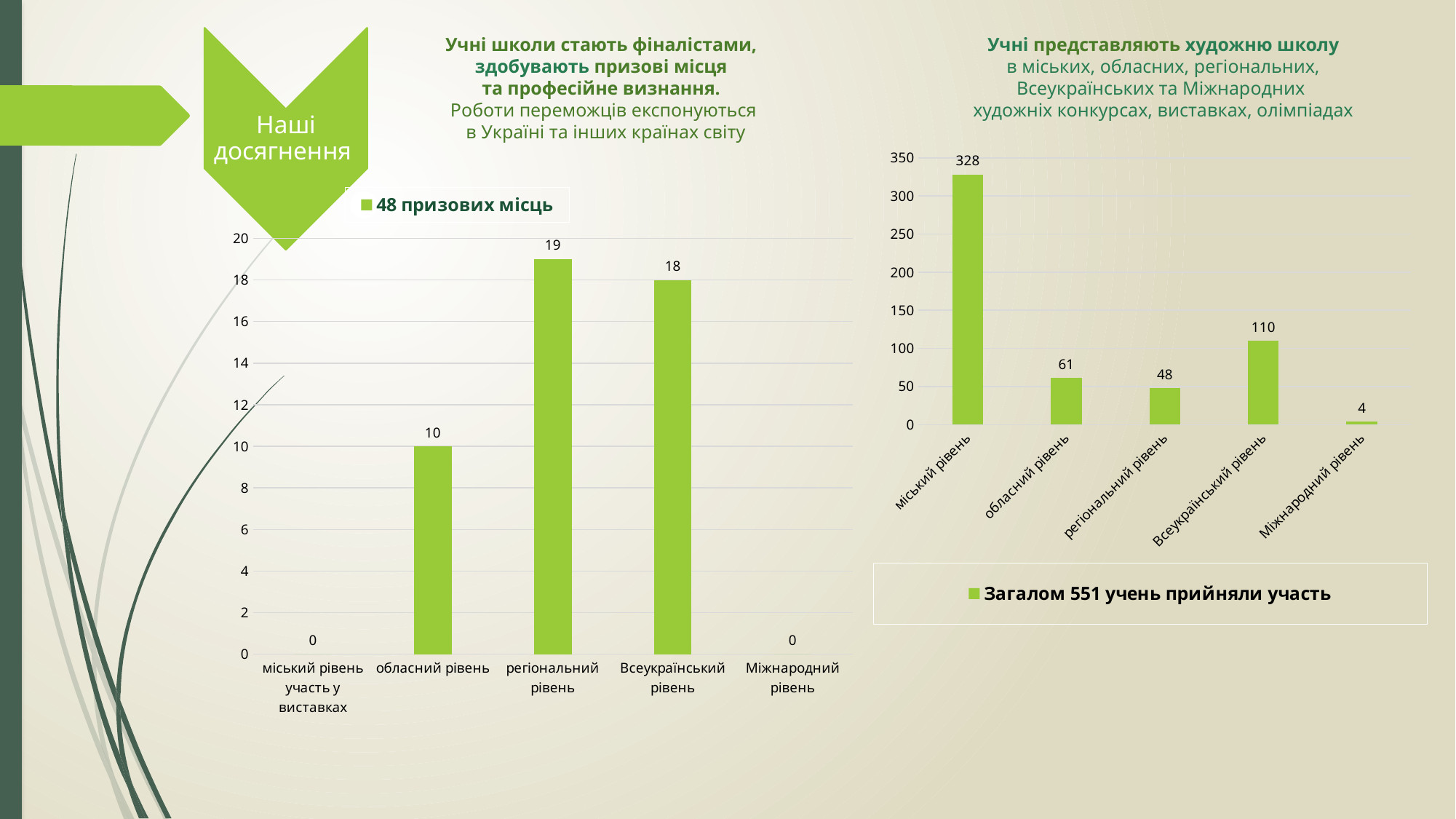
In the right chart (legend "Загалом 551 учень прийняли участь"), what is the value for міський рівень? 328 How many series does the legend of the left chart list? 1 In the right chart (legend "Загалом 551 учень прийняли участь"), what is the difference between міський рівень and Всеукраїнський рівень? 218 In the left chart (legend "48 призових місць"), what is the value for регіональний рівень? 19 In the right chart (legend "Загалом 551 учень прийняли участь"), which is larger: обласний рівень or регіональний рівень? обласний рівень In the left chart (legend "48 призових місць"), what is the difference between Всеукраїнський рівень and обласний рівень? 8 In the left chart (legend "48 призових місць"), how many categories are shown on the x axis? 5 In the right chart (legend "Загалом 551 учень прийняли участь"), which category has the lowest value? Міжнародний рівень What type of chart is the right chart (legend "Загалом 551 учень прийняли участь")? bar chart In the left chart (legend "48 призових місць"), what is the value for обласний рівень? 10 In the left chart (legend "48 призових місць"), which category has the highest value? регіональний рівень In the right chart (legend "Загалом 551 учень прийняли участь"), what is the value for Всеукраїнський рівень? 110